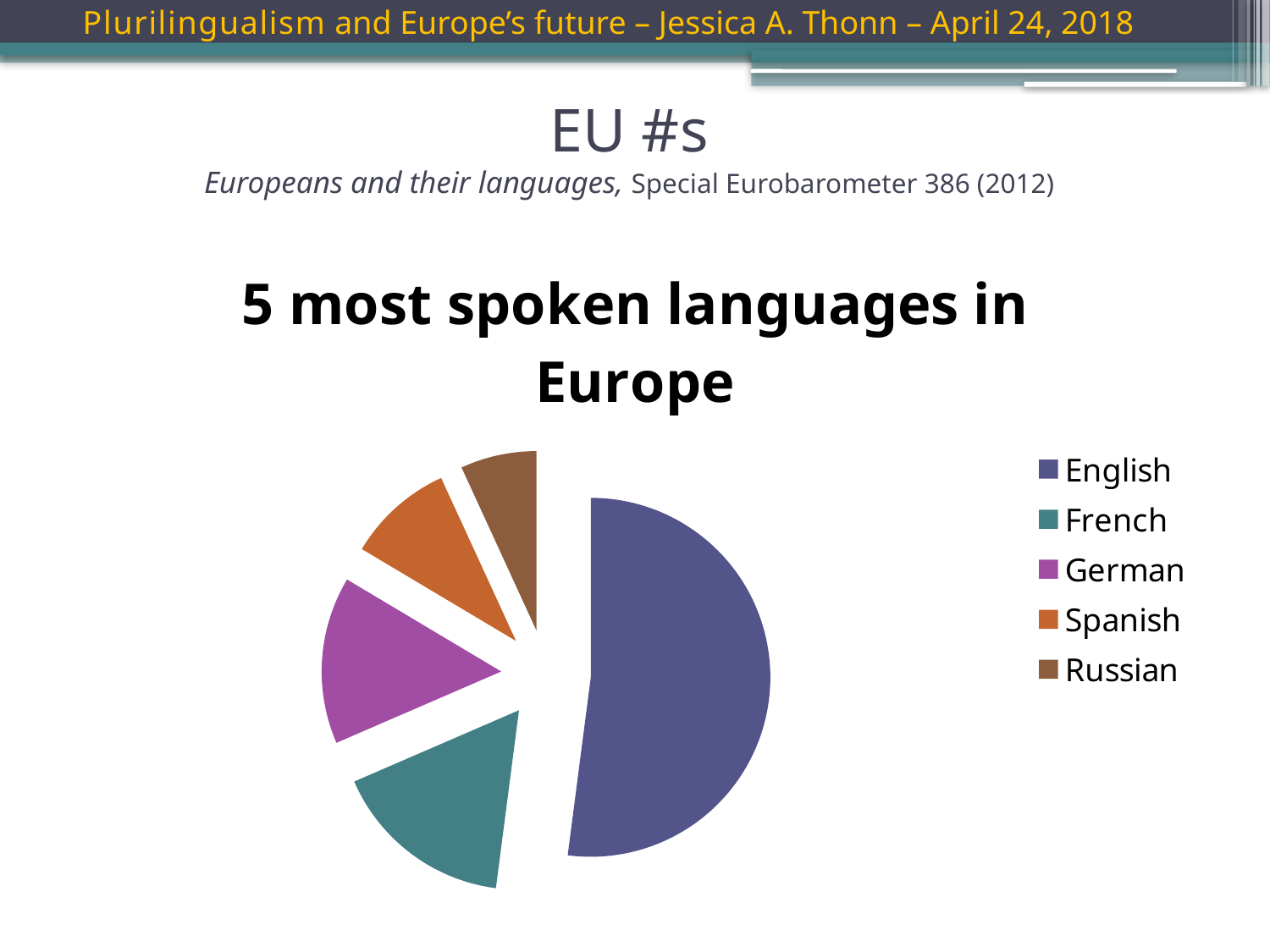
Which language is listed last in the pie chart's legend? Russian Which slice is larger in the pie chart, German or Russian? German How many slices does the pie chart have? 5 Which slice is larger in the pie chart, Spanish or Russian? Spanish What kind of chart is shown on the slide? pie chart Which slice is larger in the pie chart, English or French? English Which language has the largest slice in the pie chart? English Which language has the smallest slice in the pie chart? Russian What is the title of the pie chart? 5 most spoken languages in Europe How many entries does the legend of the pie chart list? 5